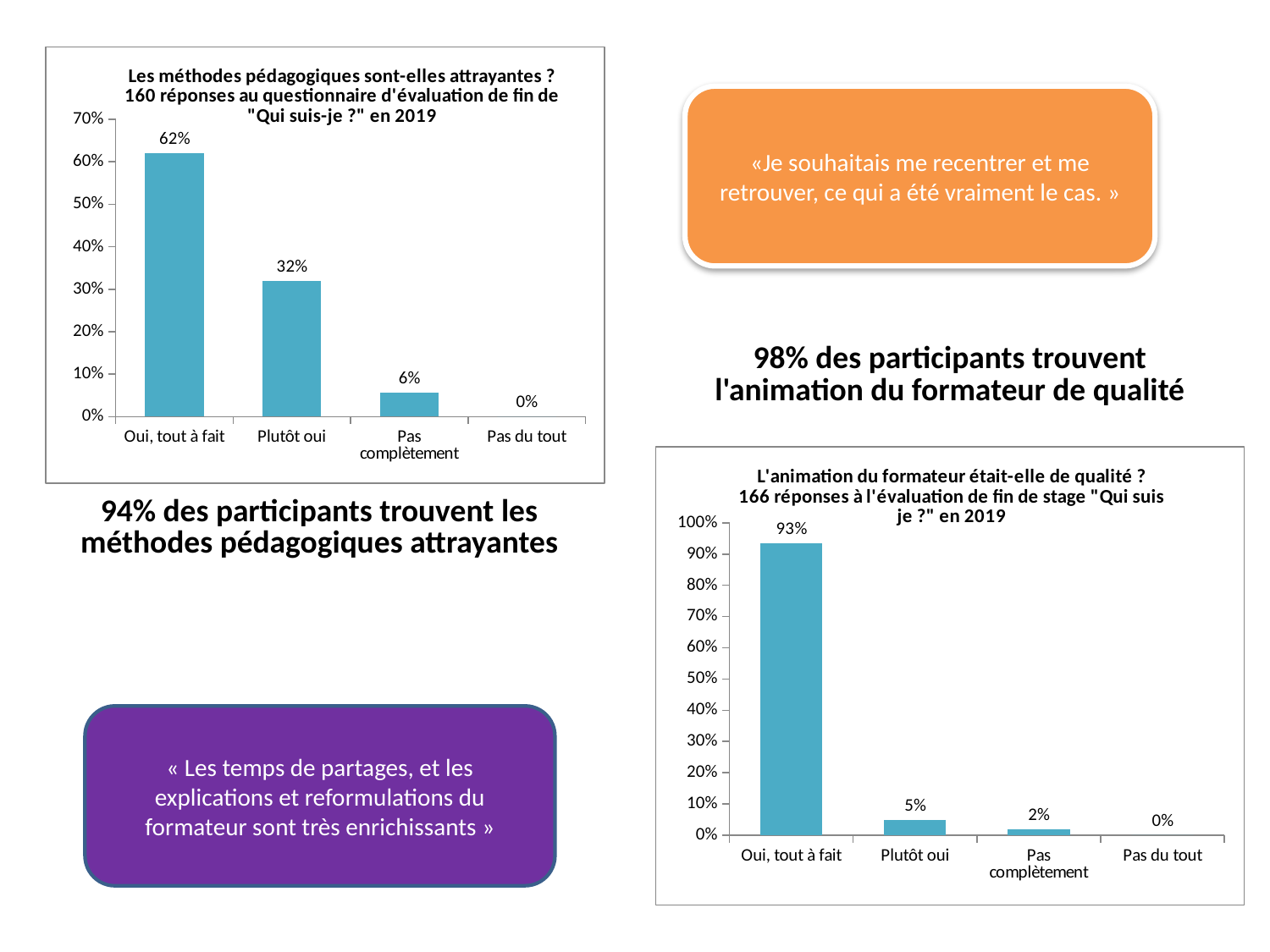
In the top-left chart (Les méthodes pédagogiques sont-elles attrayantes ?), how many categories are shown on the x axis? 4 What kind of chart is the bottom-right chart (L'animation du formateur était-elle de qualité ?)? bar chart In the bottom-right chart (L'animation du formateur était-elle de qualité ?), what is the difference between "Oui, tout à fait" and "Plutôt oui"? 88% In the bottom-right chart (L'animation du formateur était-elle de qualité ?), what is the value for "Pas complètement"? 2% In the top-left chart (Les méthodes pédagogiques sont-elles attrayantes ?), which category has the lowest value? Pas du tout In the bottom-right chart (L'animation du formateur était-elle de qualité ?), which is larger, "Plutôt oui" or "Pas complètement"? Plutôt oui In the bottom-right chart (L'animation du formateur était-elle de qualité ?), which category has the highest value? Oui, tout à fait In the top-left chart (Les méthodes pédagogiques sont-elles attrayantes ?), what is the difference between "Oui, tout à fait" and "Plutôt oui"? 30% In the top-left chart (Les méthodes pédagogiques sont-elles attrayantes ?), what is the value for "Plutôt oui"? 32% In the bottom-right chart (L'animation du formateur était-elle de qualité ?), what is the value for "Oui, tout à fait"? 93% In the top-left chart (Les méthodes pédagogiques sont-elles attrayantes ?), what is the value for "Oui, tout à fait"? 62% In the top-left chart (Les méthodes pédagogiques sont-elles attrayantes ?), do the values rise or fall from left to right along the x axis? fall